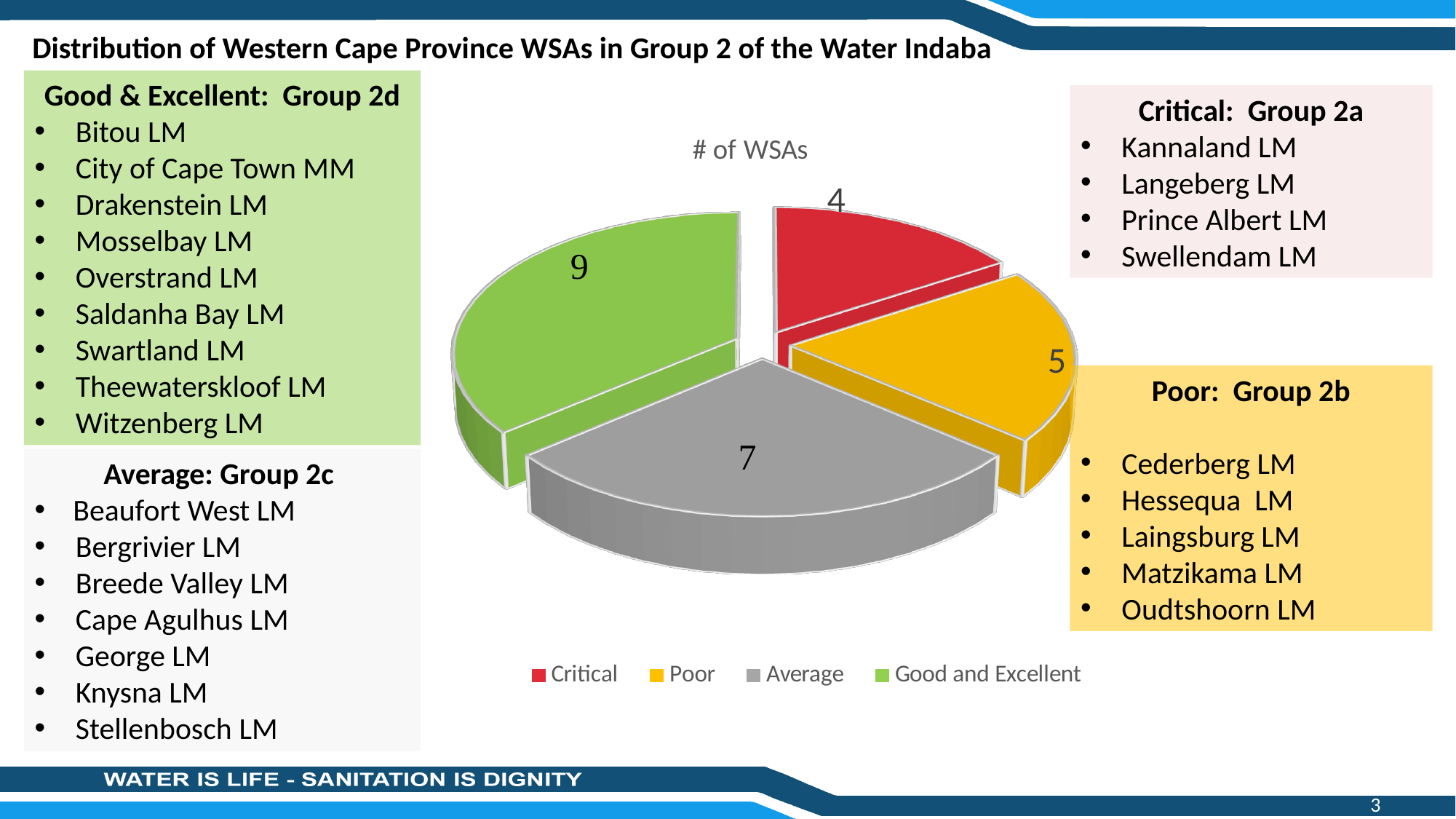
How many categories does the pie chart show? 4 How many WSAs are in the Good and Excellent category? 9 What is the title of the chart? # of WSAs Which category has the smallest number of WSAs? Critical What is the total number of WSAs across all slices of the pie chart? 25 Which has more WSAs, Poor or Average? Average What kind of chart is shown on the slide? pie chart What is the difference between the number of WSAs in Good and Excellent and in Critical? 5 Which category has the largest number of WSAs? Good and Excellent How many WSAs are in the Poor category? 5 How many WSAs are in the Average category? 7 How many WSAs are in the Critical category? 4